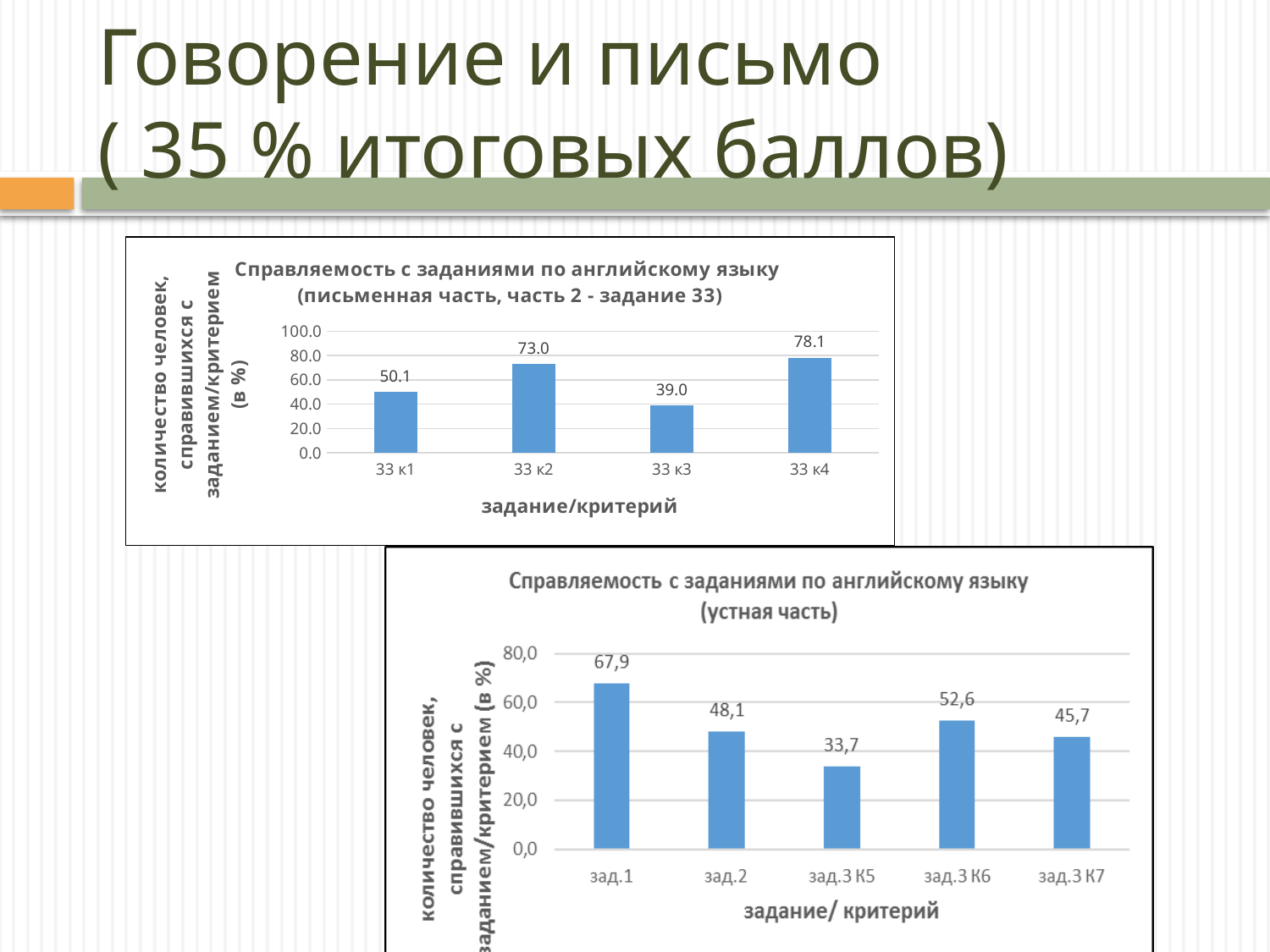
What kind of chart is the bottom chart (устная часть)? bar chart In the bottom chart (устная часть), which category has the highest value? зад.1 In the top chart (письменная часть, задание 33), what is the difference between the values for 33 к4 and 33 к1? 28.0 In the top chart (письменная часть, задание 33), which category has the lowest value? 33 к3 In the top chart (письменная часть, задание 33), which category has the highest value? 33 к4 In the bottom chart (устная часть), how many categories are shown on the x axis? 5 In the bottom chart (устная часть), what is the value for зад.3 К6? 52,6 In the bottom chart (устная часть), which is larger, the value for зад.2 or the value for зад.3 К7? зад.2 In the bottom chart (устная часть), which category has the lowest value? зад.3 К5 What is the x-axis title of the top chart (письменная часть, задание 33)? задание/критерий In the top chart (письменная часть, задание 33), how many categories are shown on the x axis? 4 In the top chart (письменная часть, задание 33), what is the value for 33 к2? 73.0